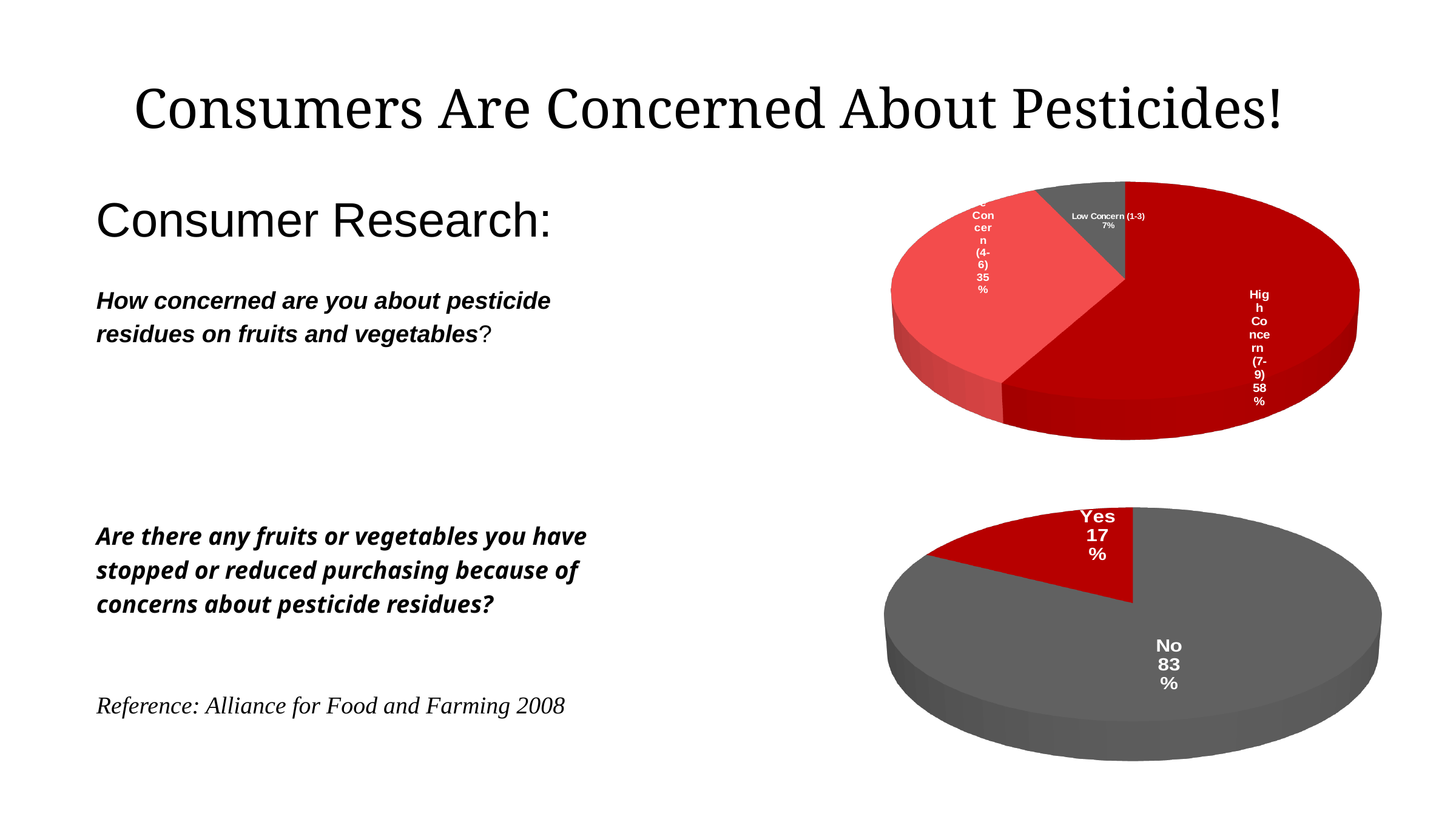
In the top pie chart, what is the difference in percentage points between High Concern (7-9) and Low Concern (1-3)? 51 In the top pie chart, what share is labelled for Low Concern (1-3)? 7% In the top pie chart, which slice is the largest? High Concern (7-9) In the bottom pie chart, what share is labelled for Yes? 17% How many slices does the top pie chart have? 3 In the bottom pie chart, what colour is the Yes slice? Red In the top pie chart, what share is labelled for High Concern (7-9)? 58% In the top pie chart, what share is labelled for the (4-6) concern slice? 35% In the top pie chart, which slice is the smallest? Low Concern (1-3) In the bottom pie chart, which is larger, Yes or No? No In the bottom pie chart, what share is labelled for No? 83% What kind of chart is the bottom chart on the slide? Pie chart